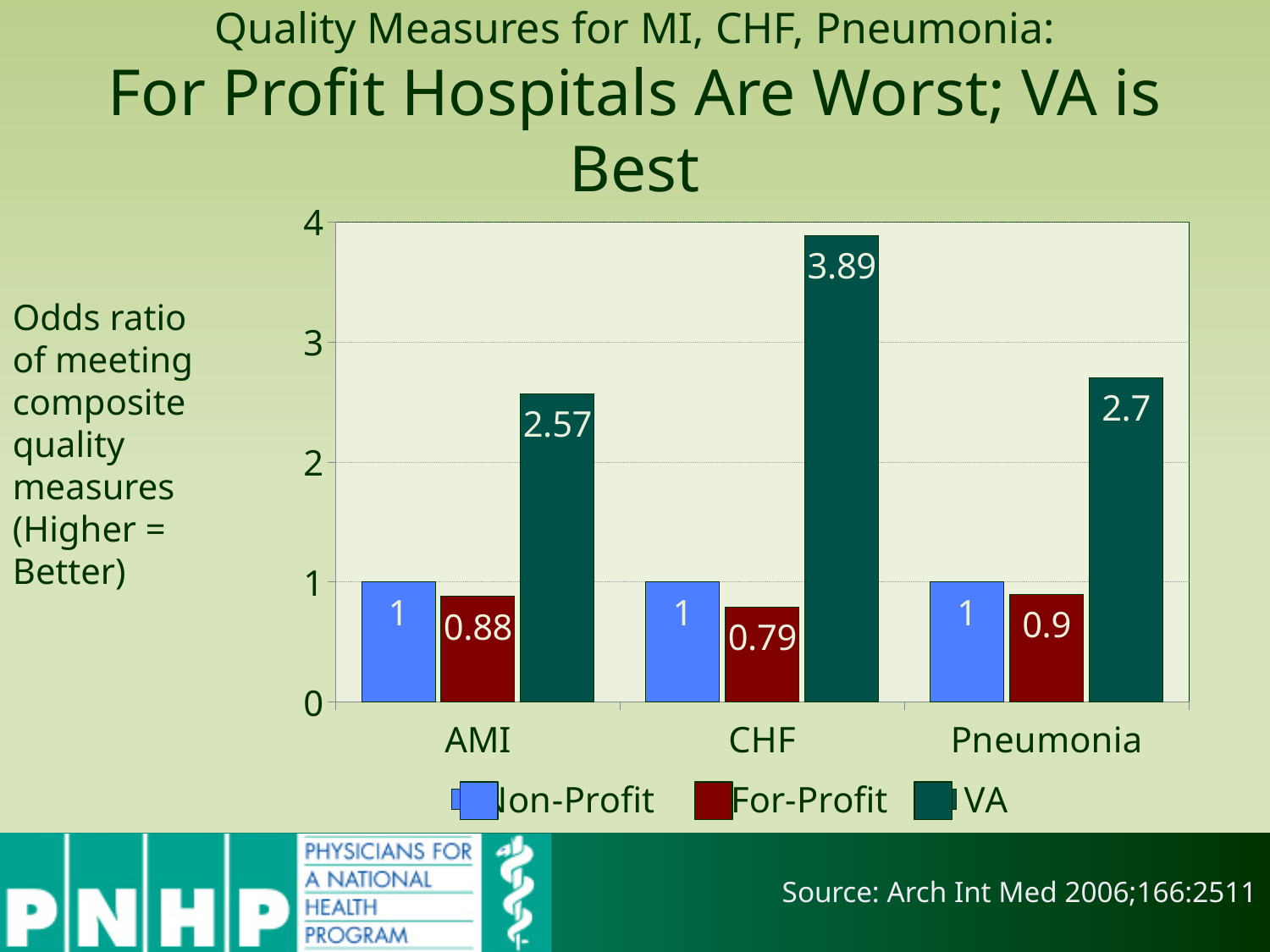
Is the VA odds ratio for AMI greater or less than 2? greater What is the For-Profit odds ratio for CHF? 0.79 Which condition has the lowest For-Profit odds ratio? CHF Which condition has the highest VA odds ratio? CHF What is the VA odds ratio for CHF? 3.89 What is the difference between the VA and Non-Profit odds ratios for AMI? 1.57 What kind of chart is shown on the slide? bar chart How many series does the legend list? 3 Which is larger, the For-Profit odds ratio for Pneumonia or for AMI? Pneumonia What is the For-Profit odds ratio for AMI? 0.88 How many conditions are shown on the x axis? 3 What is the VA odds ratio for Pneumonia? 2.7